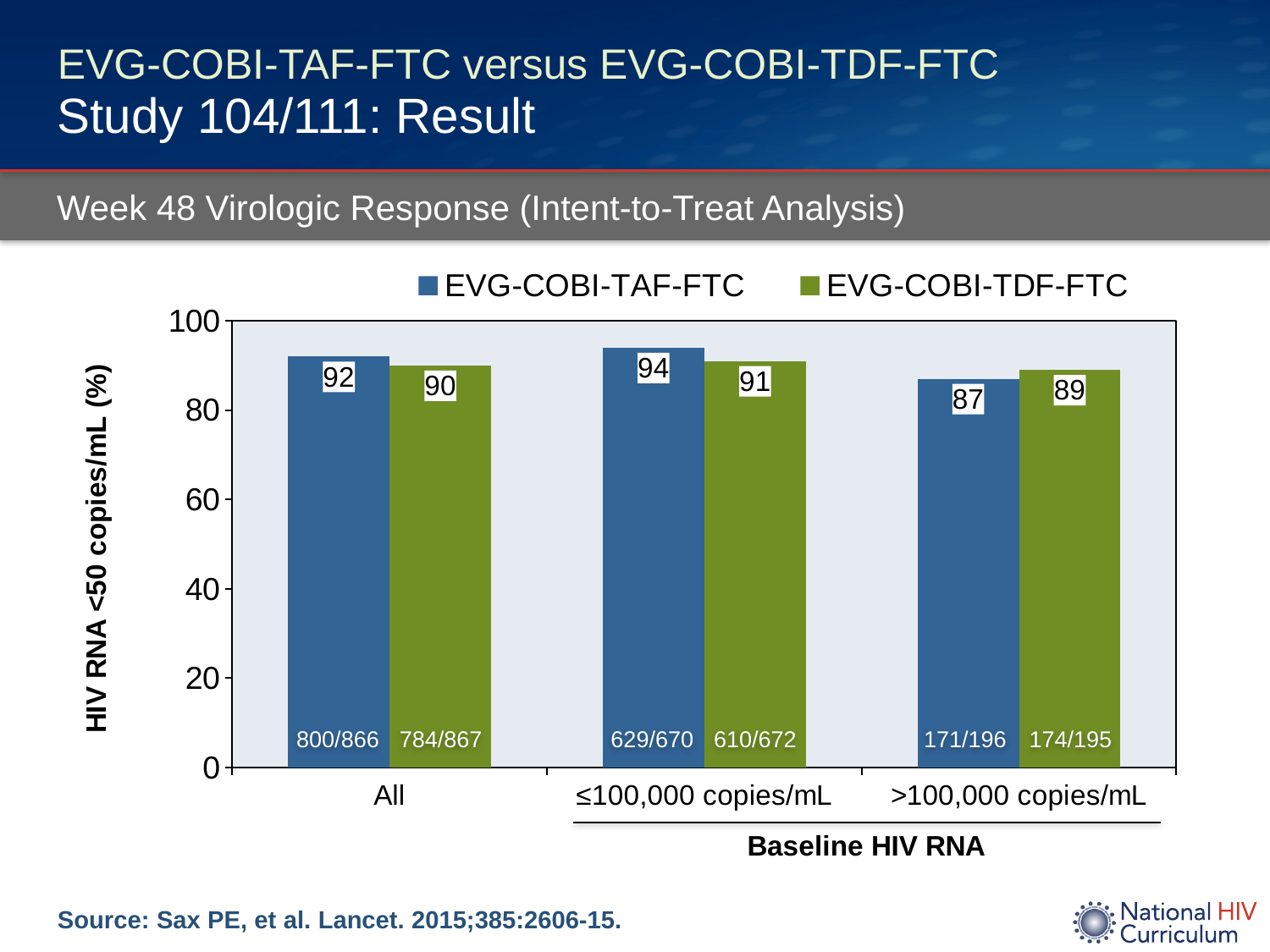
How many categories are shown on the x axis? 3 What is the value for EVG-COBI-TDF-FTC in the >100,000 copies/mL category? 89 Is the value for EVG-COBI-TAF-FTC in the >100,000 copies/mL category greater or less than 80? greater Which category has the highest value for EVG-COBI-TAF-FTC? ≤100,000 copies/mL What is the value for EVG-COBI-TAF-FTC in the All category? 92 How many series does the legend list? 2 What is the difference between the EVG-COBI-TAF-FTC and EVG-COBI-TDF-FTC values in the ≤100,000 copies/mL category? 3 What is the value for EVG-COBI-TDF-FTC in the ≤100,000 copies/mL category? 91 Which category has the lowest value for EVG-COBI-TAF-FTC? >100,000 copies/mL What is the label of the y axis? HIV RNA <50 copies/mL (%) What kind of chart is shown on the slide? bar chart In the >100,000 copies/mL category, which series has the larger value, EVG-COBI-TAF-FTC or EVG-COBI-TDF-FTC? EVG-COBI-TDF-FTC